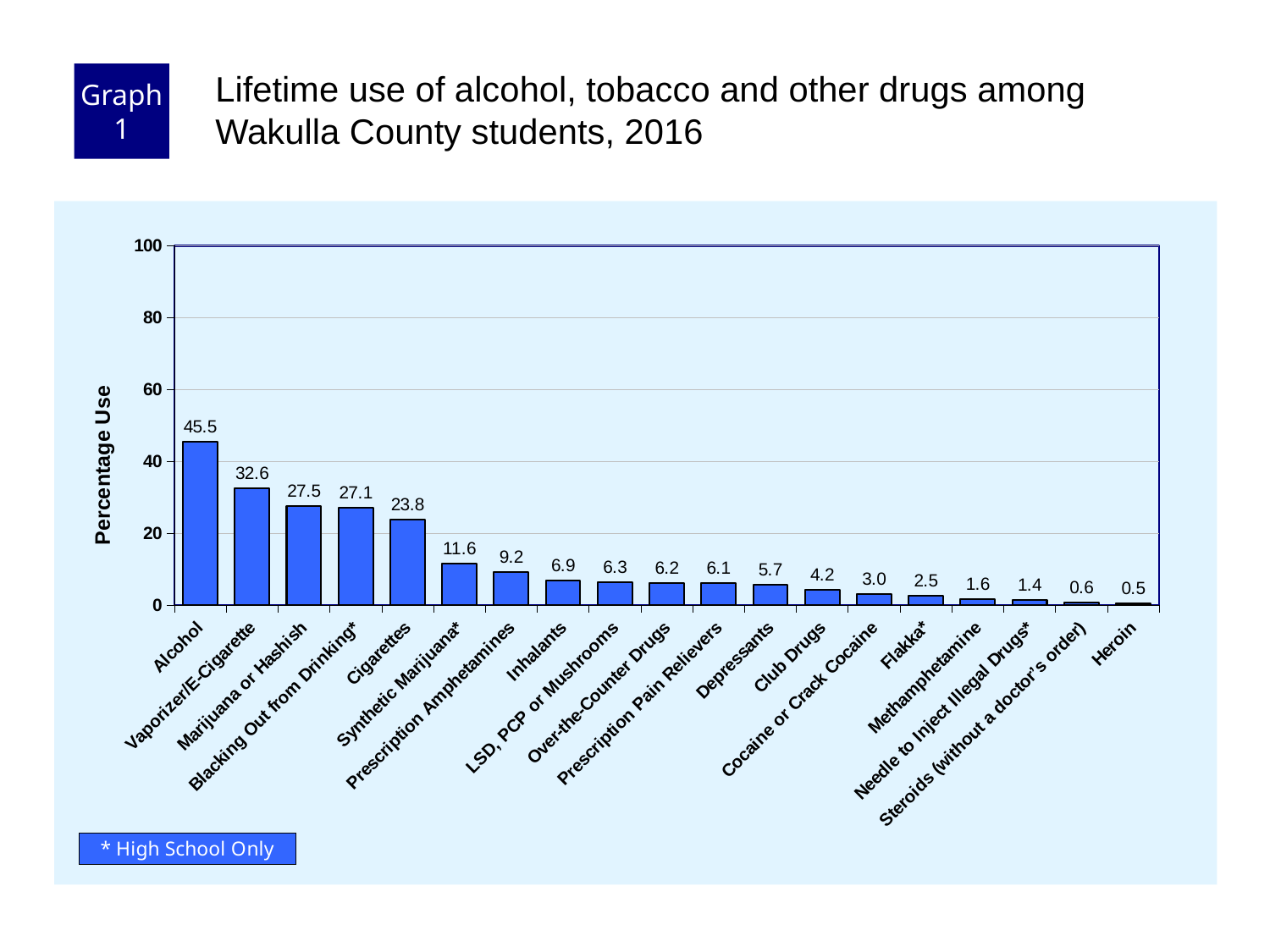
What is the difference between the values for Alcohol and Cigarettes? 21.7 What is the value shown for Synthetic Marijuana*? 11.6 Which category has the lowest lifetime use percentage? Heroin Which is larger, the value for Inhalants or the value for Depressants? Inhalants What is the label of the y axis? Percentage Use What is the value shown for Vaporizer/E-Cigarette? 32.6 What is the value shown for Cocaine or Crack Cocaine? 3.0 How many categories are shown on the x axis? 19 Which category has the highest lifetime use percentage? Alcohol What kind of chart is shown on the slide? Bar chart What is the lifetime use percentage for Alcohol? 45.5 Is the value for Marijuana or Hashish greater or less than 20? greater